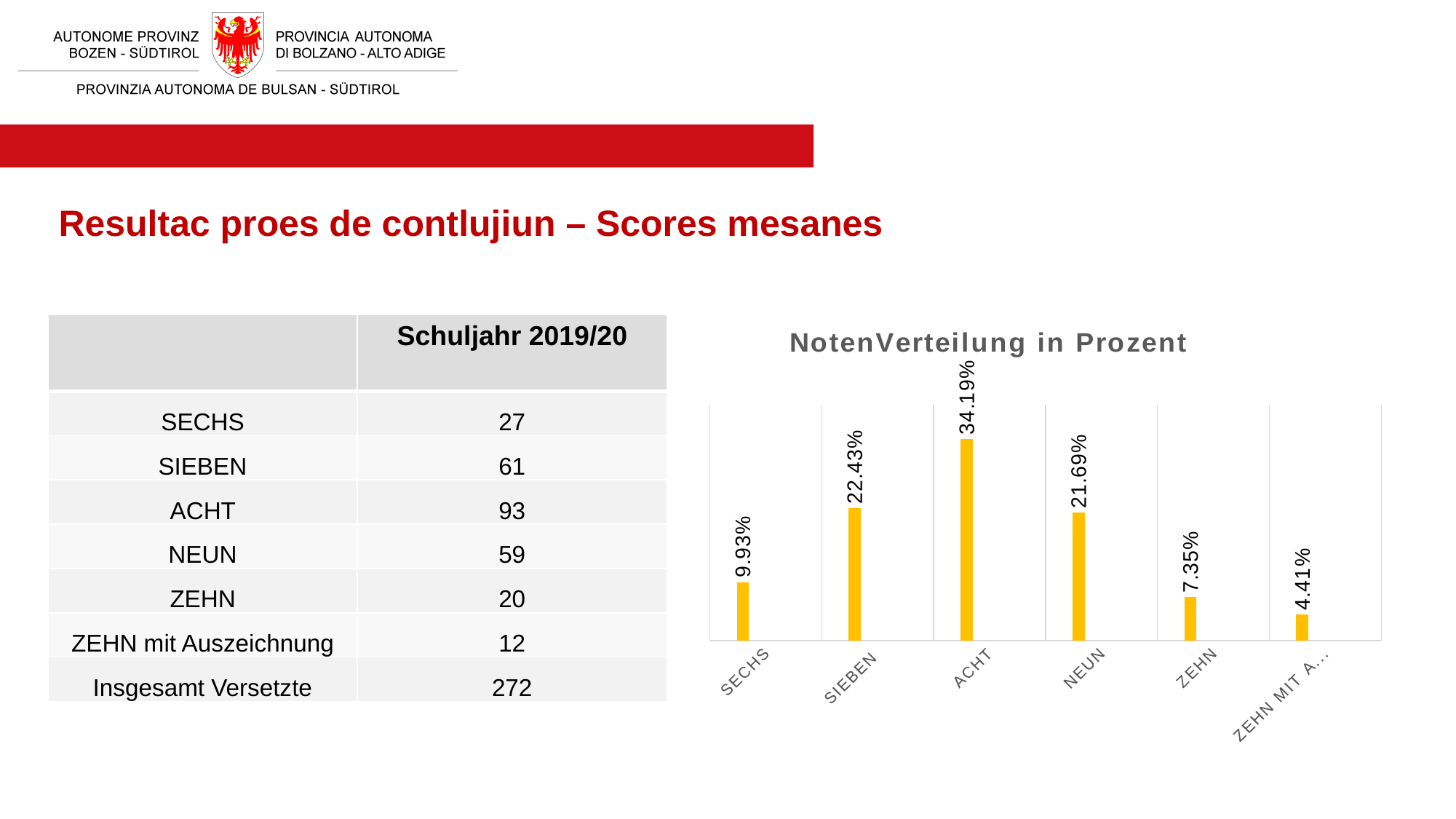
What is the value for ZEHN in the chart? 7.35% What kind of chart is shown on the slide? bar chart Which is larger in the chart, SIEBEN or NEUN? SIEBEN What is the title of the chart? NotenVerteilung in Prozent Do the values rise or fall from ACHT to the rightmost bar of the chart? fall What is the value for NEUN in the chart? 21.69% What is the value of the lowest bar in the chart? 4.41% What is the difference between the values for ACHT and SECHS in the chart? 24.26% How many bars does the chart have? 6 Which category has the highest value in the chart? ACHT What is the value for SECHS in the chart? 9.93% What is the value for ACHT in the chart? 34.19%